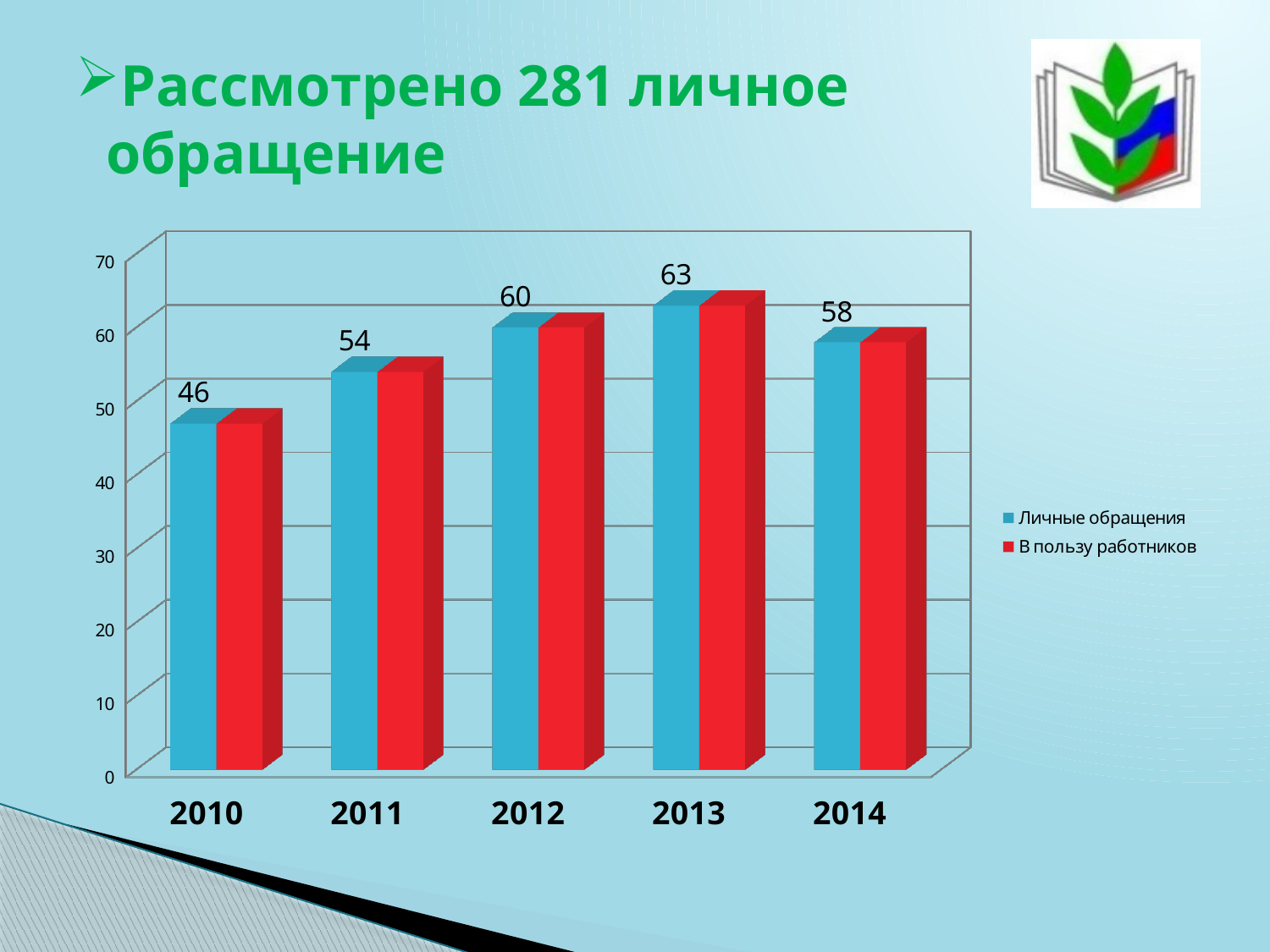
Which year has the highest value for Личные обращения? 2013 What is the difference between the Личные обращения values for 2013 and 2010? 17 How many years are shown on the x axis? 5 What is the value of Личные обращения for 2010? 46 What is the value of Личные обращения for 2013? 63 Do the Личные обращения values rise or fall from 2010 to 2013? rise What is the value of Личные обращения for 2012? 60 What kind of chart is shown on the slide? bar chart Which year has the lowest value for Личные обращения? 2010 How many series does the legend list? 2 Is the value for В пользу работников in 2013 greater or less than 50? greater Which year has a larger Личные обращения value, 2012 or 2014? 2012